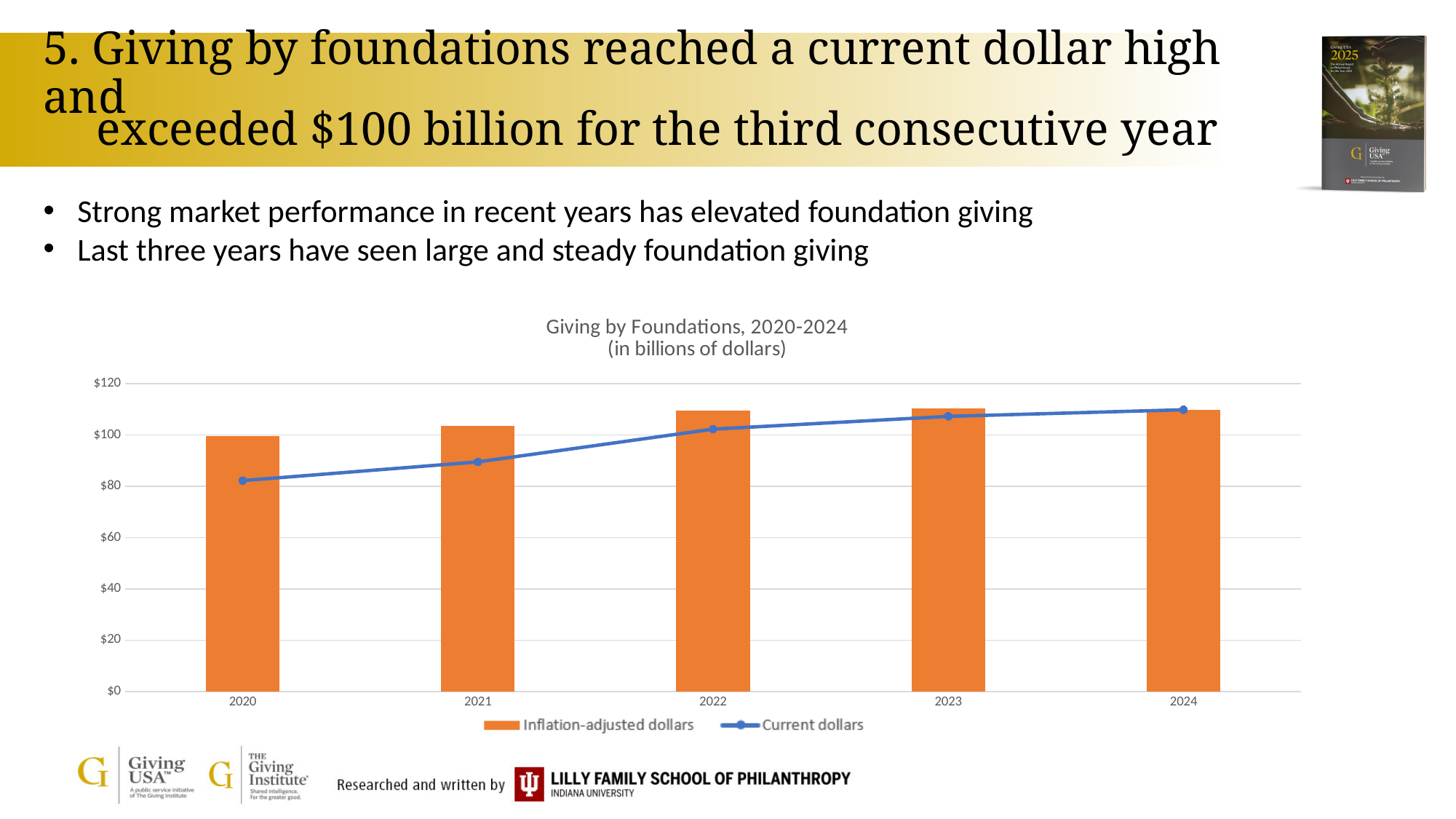
Which series is shown as orange bars? Inflation-adjusted dollars Does the Current dollars line rise or fall from 2020 to 2024? Rises How many series does the legend list? 2 How many years are shown on the x axis? 5 Is the Inflation-adjusted dollars value for 2022 greater or less than $100? greater Which year has the lowest Current dollars value? 2020 Which year has the highest Current dollars value? 2024 In 2021, which is larger: Inflation-adjusted dollars or Current dollars? Inflation-adjusted dollars Is the Current dollars value for 2021 greater or less than $100? less Which year has the lowest Inflation-adjusted dollars value? 2020 What kind of chart is shown on the slide? A combined bar and line chart What is the title of the chart? Giving by Foundations, 2020-2024 (in billions of dollars)